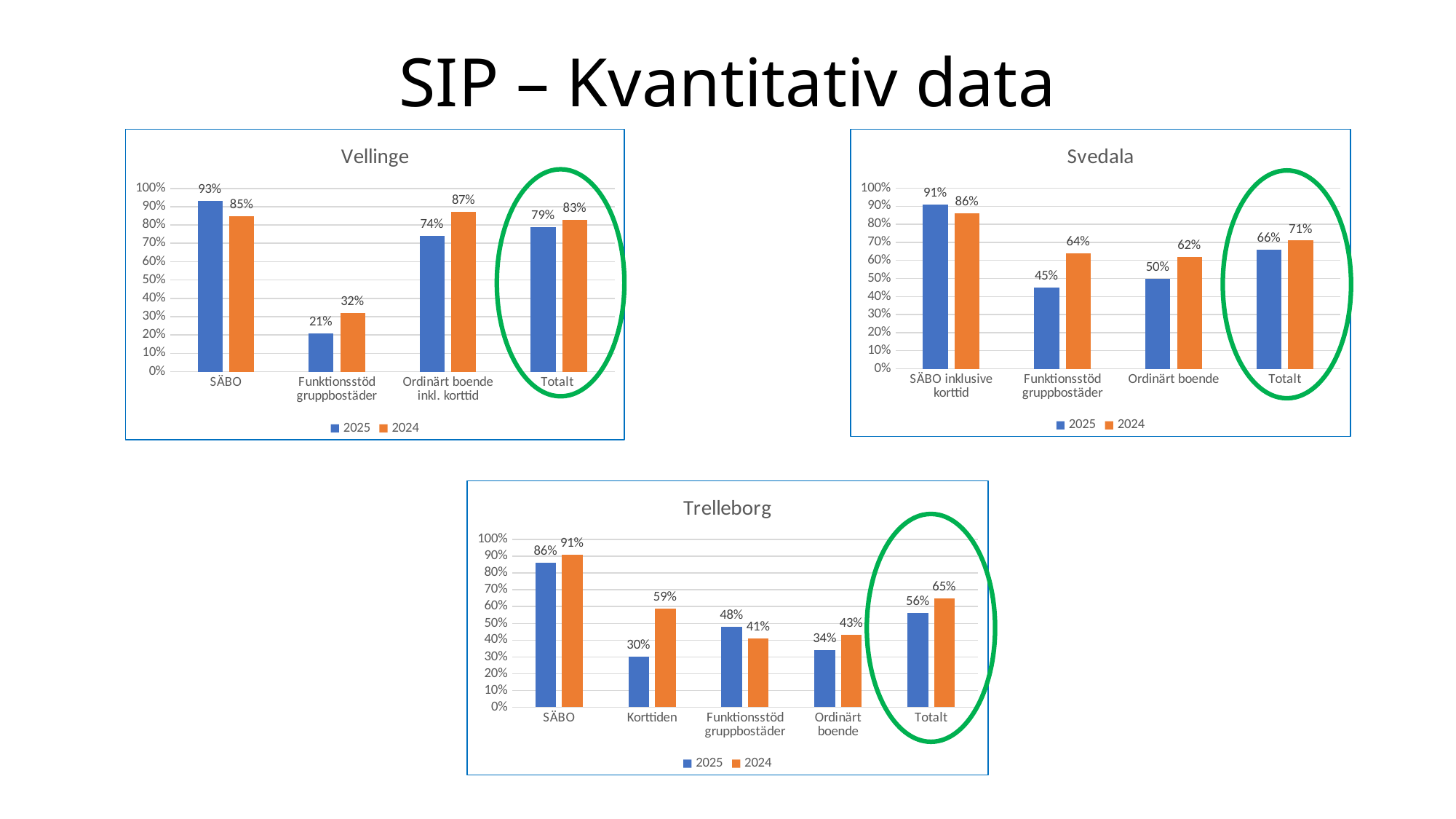
In the Trelleborg chart, how many categories are shown on the x axis? 5 In the Svedala chart, what is the 2025 value for Ordinärt boende? 50% In the Trelleborg chart, what is the 2024 value for Korttiden? 59% How many series does the legend of the Svedala chart list? 2 What type of chart is the Trelleborg chart? Bar chart In the Trelleborg chart, what is the difference between the 2024 and 2025 values for Totalt? 9% In the Svedala chart, which category has the highest 2024 value? SÄBO inklusive korttid In the Vellinge chart, which category has the lowest 2025 value? Funktionsstöd gruppbostäder In the Vellinge chart, what is the value for SÄBO in 2025? 93% In the Vellinge chart, what is the difference between the 2024 and 2025 values for Totalt? 4% In the Svedala chart, is the 2025 value for Totalt larger or smaller than the 2024 value? smaller In the Vellinge chart, what is the 2024 value for Funktionsstöd gruppbostäder? 32%